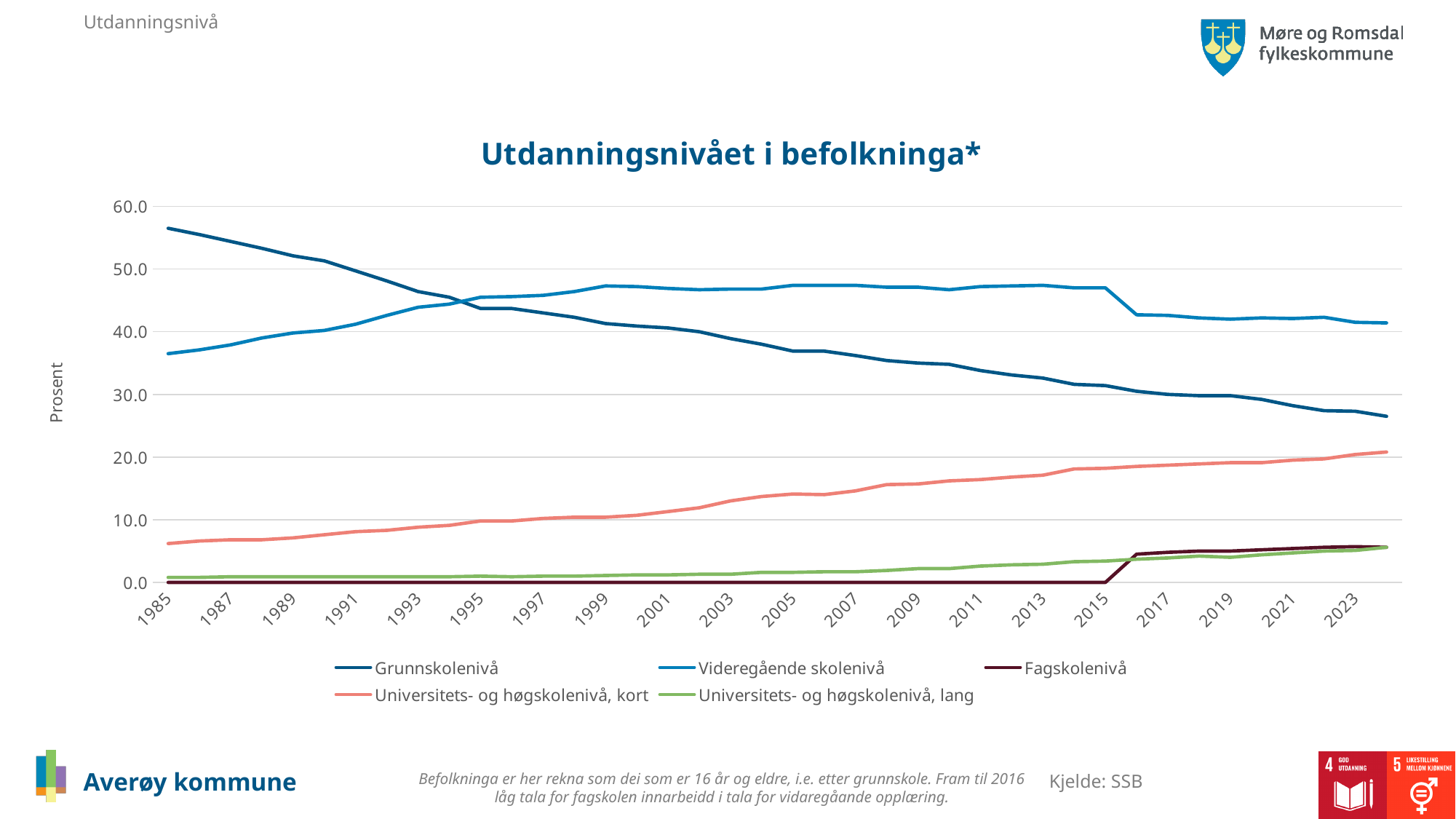
What kind of chart is shown on the slide? line chart In 2023, which is higher: Grunnskolenivå or Videregående skolenivå? Videregående skolenivå Is the value for Grunnskolenivå in 1985 greater or less than 50.0? greater What is the label on the y axis? Prosent Does the value for Universitets- og høgskolenivå, kort rise or fall from 1985 to 2023? rise In 1985, which is higher: Grunnskolenivå or Videregående skolenivå? Grunnskolenivå How many series does the legend list? 5 Does the value for Grunnskolenivå rise or fall from 1985 to 2023? fall Is the value for Universitets- og høgskolenivå, kort in 1985 greater or less than 10.0? less Is the value for Videregående skolenivå in 2023 greater or less than 40.0? greater What is the title of the chart? Utdanningsnivået i befolkninga* Which series has the highest value in 2023? Videregående skolenivå